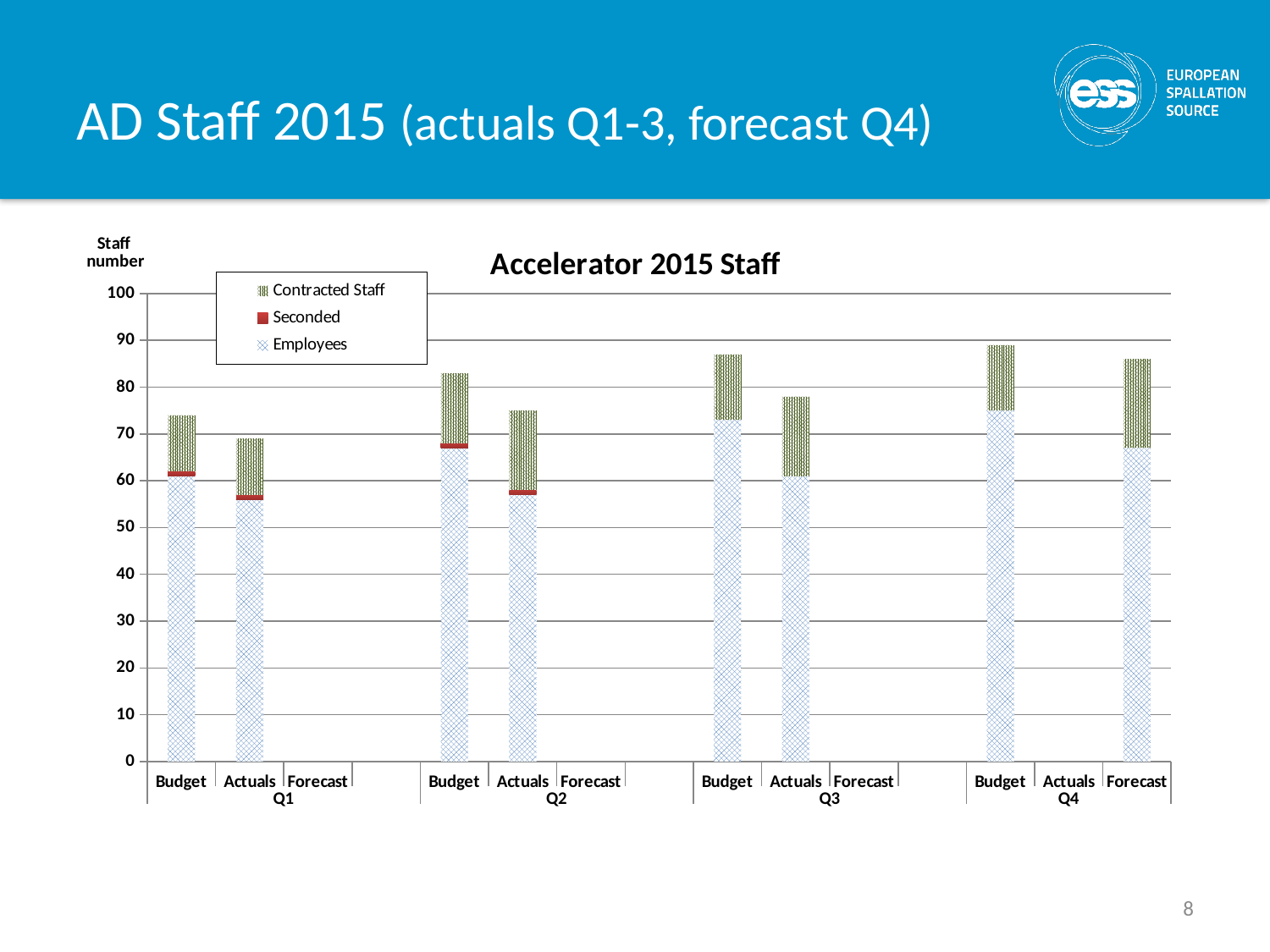
Which series is shown in red in the legend? Seconded What is the title of the chart? Accelerator 2015 Staff Is the total Budget bar for Q3 greater or less than 90? less Is the total Budget bar for Q1 greater or less than 70? greater In Q2, which total bar is larger, Budget or Actuals? Budget Do the Budget bar totals rise or fall from Q1 to Q4? rise How many quarters are shown along the x axis? 4 Is the total Forecast bar for Q4 greater or less than 80? greater Which plotted bar has the lowest total staff number? Q1 Actuals What kind of chart is shown on the slide? Stacked bar chart How many series does the legend list? 3